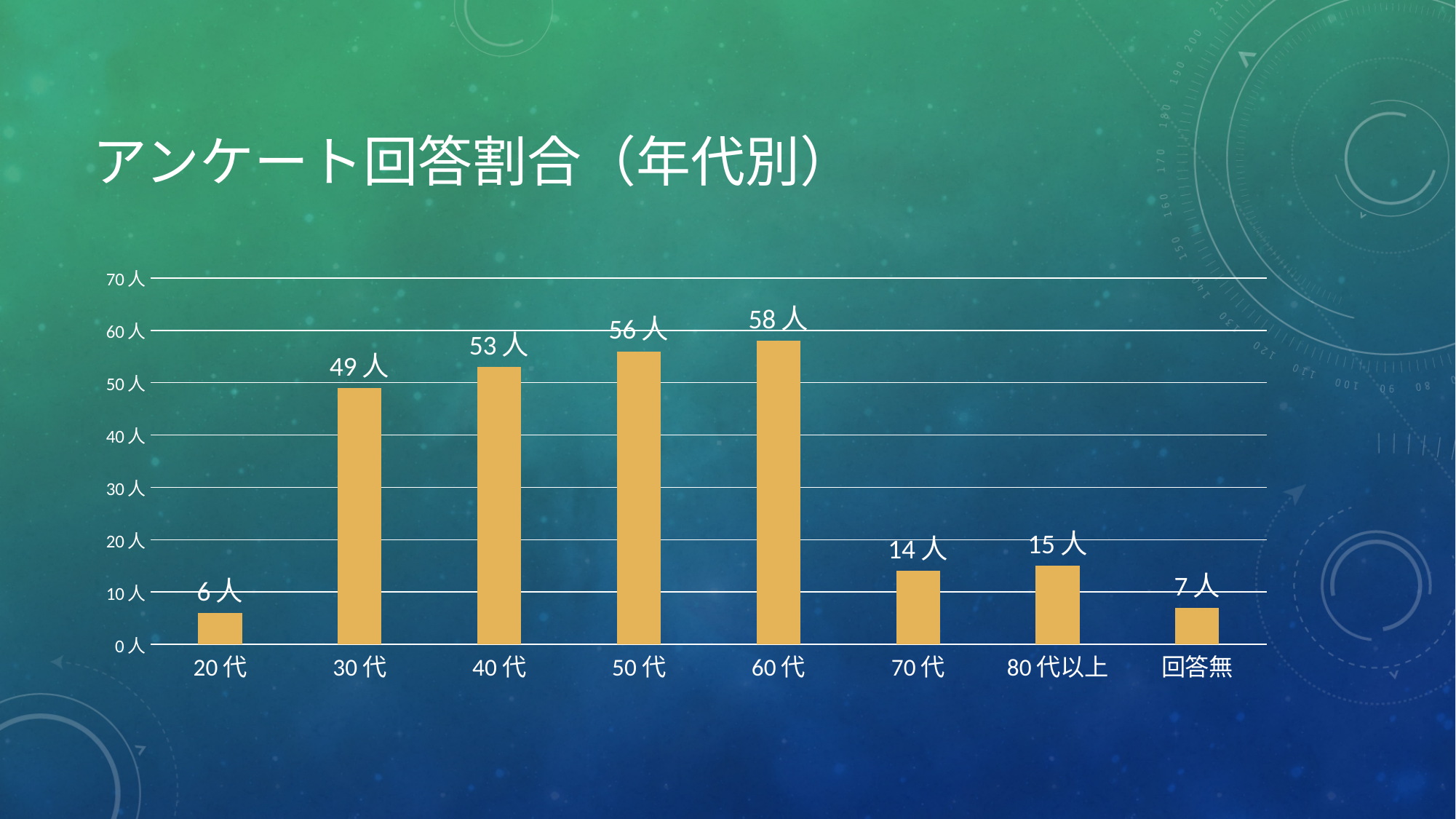
What is the difference between the values for 40代 and 70代? 39 人 Which category has the lowest value? 20代 Which is larger, the value for 80代以上 or the value for 70代? 80代以上 What is the value for 30代? 49 人 Is the value for 50代 greater or less than 50 人? greater What is the difference between the values for 60代 and 50代? 2 人 What is the value for 回答無? 7 人 What is the value for 70代? 14 人 Which category has the highest value? 60代 What kind of chart is shown on the slide? bar chart How many categories are shown on the x axis? 8 What is the title of the slide? アンケート回答割合（年代別）